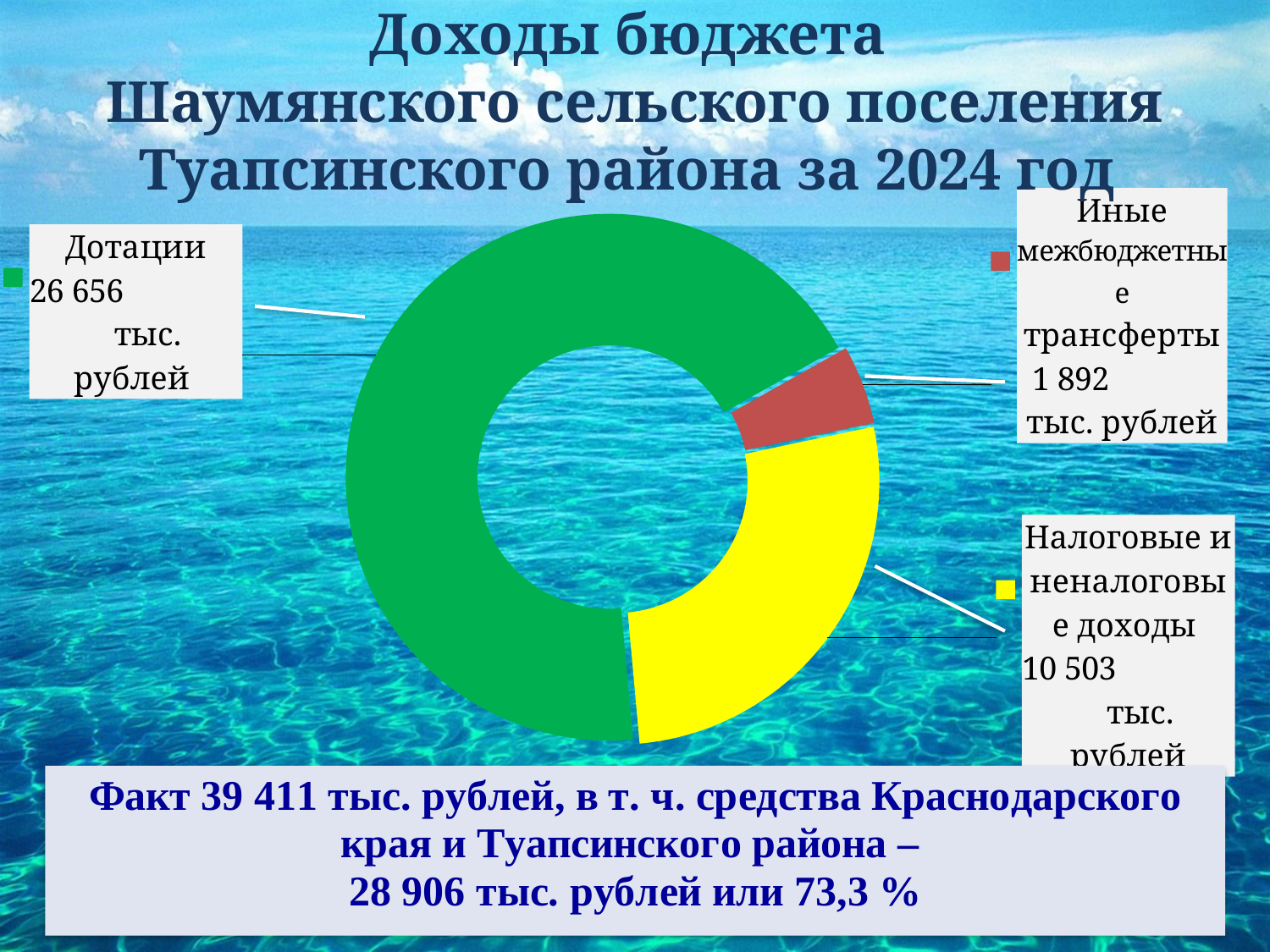
What is the difference between Дотации and Налоговые и неналоговые доходы? 16 153 тыс. рублей What is the value shown for Дотации? 26 656 тыс. рублей What colour is the slice for Дотации? green What is the difference between Налоговые и неналоговые доходы and Иные межбюджетные трансферты? 8 611 тыс. рублей What is the value shown for Налоговые и неналоговые доходы? 10 503 тыс. рублей What is the value shown for Иные межбюджетные трансферты? 1 892 тыс. рублей Which category has the largest value in the chart? Дотации Which labelled category has the smallest value in the chart? Иные межбюджетные трансферты Which is larger, Дотации or Налоговые и неналоговые доходы? Дотации What kind of chart is shown on the slide? doughnut chart Which is larger, Иные межбюджетные трансферты or Налоговые и неналоговые доходы? Налоговые и неналоговые доходы What colour is the slice for Налоговые и неналоговые доходы? yellow